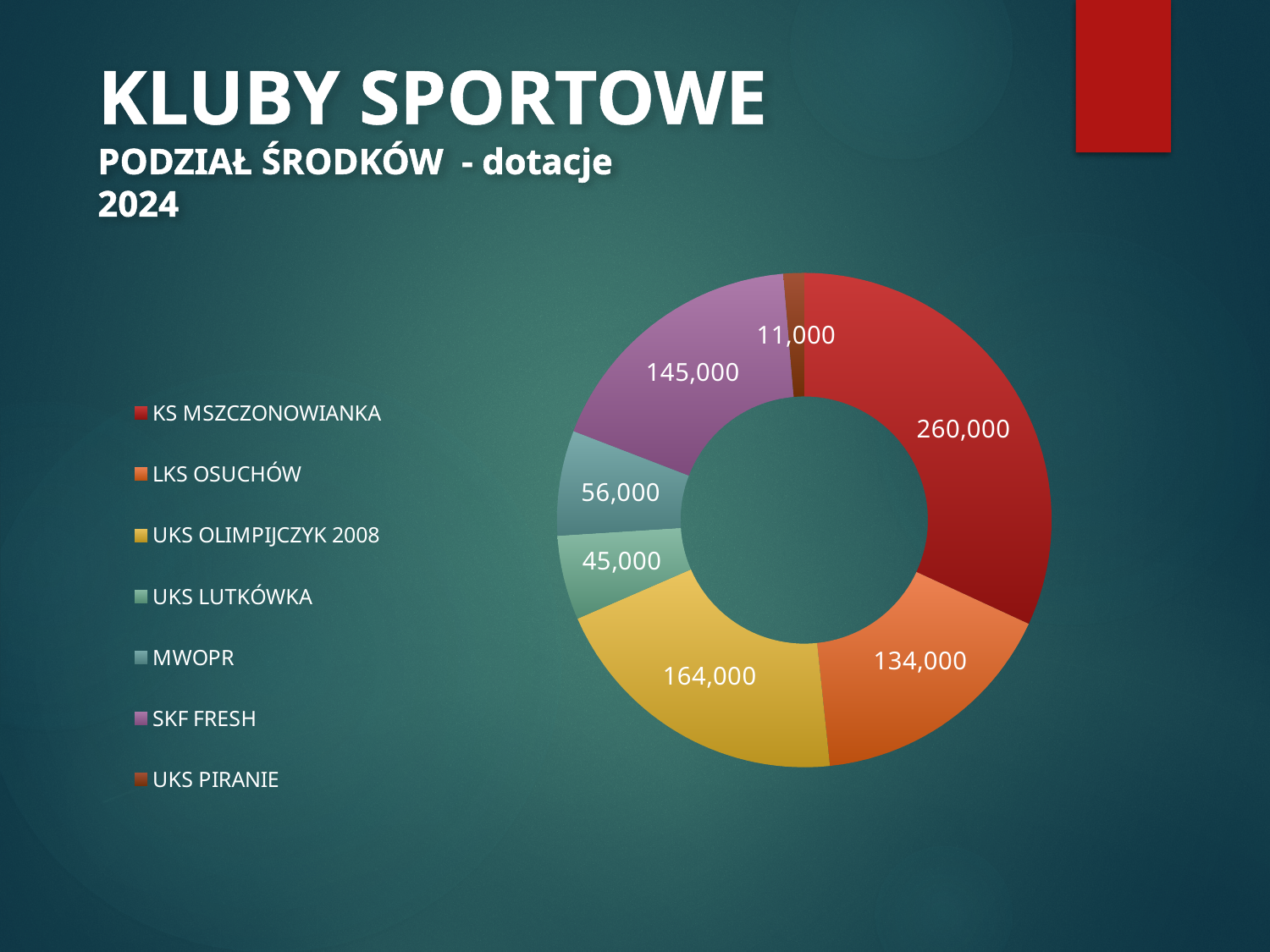
What is the total of all values shown in the chart? 815,000 Which club received the largest amount? KS MSZCZONOWIANKA What is the difference between the values for UKS OLIMPIJCZYK 2008 and LKS OSUCHÓW? 30,000 What value is shown for KS MSZCZONOWIANKA? 260,000 What value is shown for UKS PIRANIE? 11,000 Which club received the smallest amount? UKS PIRANIE How many clubs (slices) are shown in the chart? 7 Which is larger, the value for MWOPR or the value for UKS LUTKÓWKA? MWOPR What value is shown for SKF FRESH? 145,000 Which colour represents LKS OSUCHÓW in the legend? orange What value is shown for UKS LUTKÓWKA? 45,000 What kind of chart is shown on the slide? doughnut chart